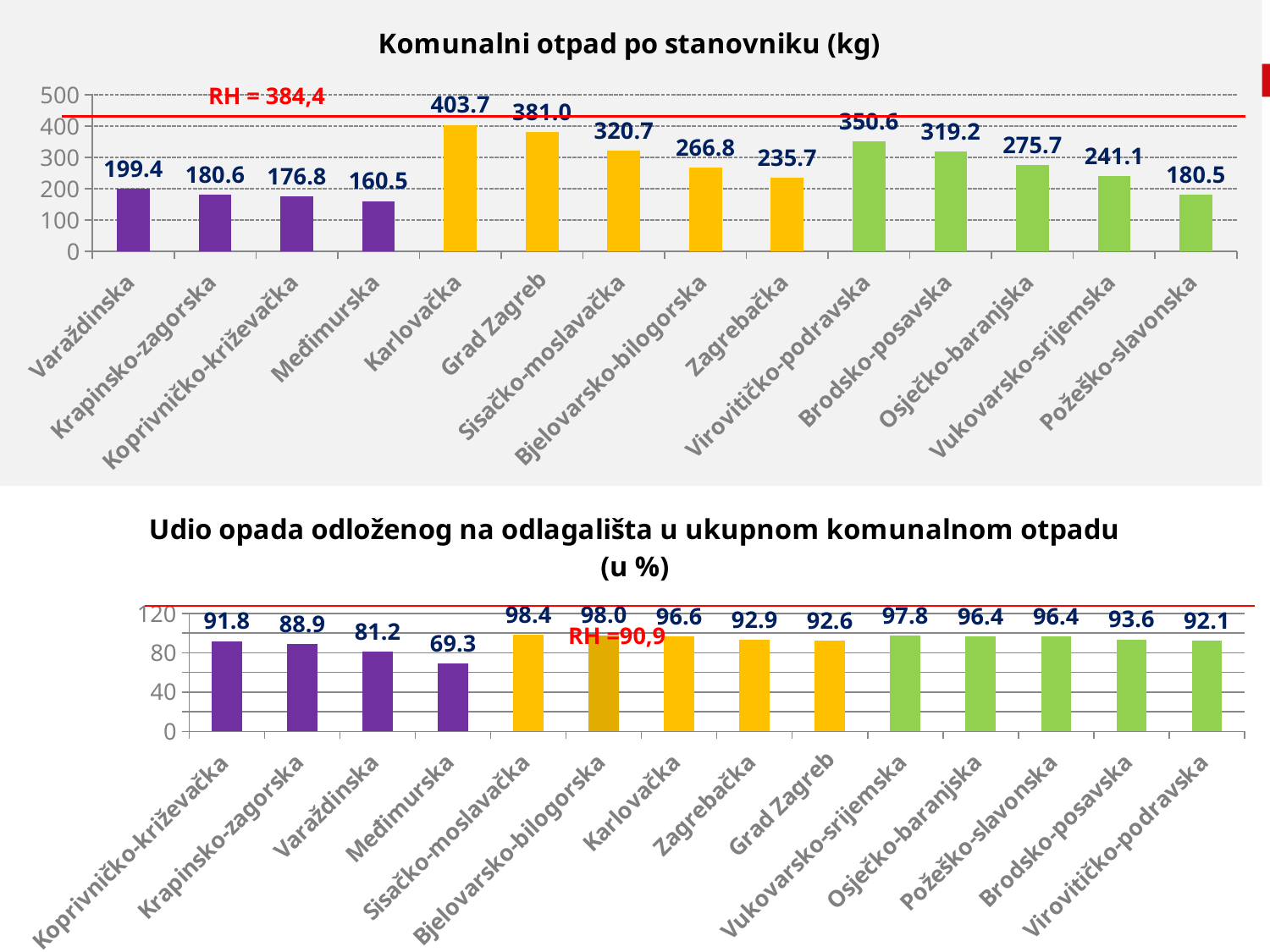
In the bottom chart 'Udio opada odloženog na odlagališta u ukupnom komunalnom otpadu (u %)', what is the difference between Sisačko-moslavačka and Međimurska? 29.1 In the chart 'Komunalni otpad po stanovniku (kg)', what value is given for RH on the red line? 384,4 In the chart 'Komunalni otpad po stanovniku (kg)', how many categories are shown? 14 In the bottom chart 'Udio opada odloženog na odlagališta u ukupnom komunalnom otpadu (u %)', which category has the highest value? Sisačko-moslavačka In the bottom chart 'Udio opada odloženog na odlagališta u ukupnom komunalnom otpadu (u %)', what is the value for Međimurska? 69.3 In the chart 'Komunalni otpad po stanovniku (kg)', which is larger, Virovitičko-podravska or Sisačko-moslavačka? Virovitičko-podravska In the chart 'Komunalni otpad po stanovniku (kg)', what is the value for Karlovačka? 403.7 What type of chart is the bottom chart 'Udio opada odloženog na odlagališta u ukupnom komunalnom otpadu (u %)'? Bar chart In the chart 'Komunalni otpad po stanovniku (kg)', which category has the highest value? Karlovačka In the chart 'Komunalni otpad po stanovniku (kg)', what is the difference between Karlovačka and Grad Zagreb? 22.7 In the bottom chart 'Udio opada odloženog na odlagališta u ukupnom komunalnom otpadu (u %)', what is the value for Vukovarsko-srijemska? 97.8 In the chart 'Komunalni otpad po stanovniku (kg)', which category has the lowest value? Međimurska